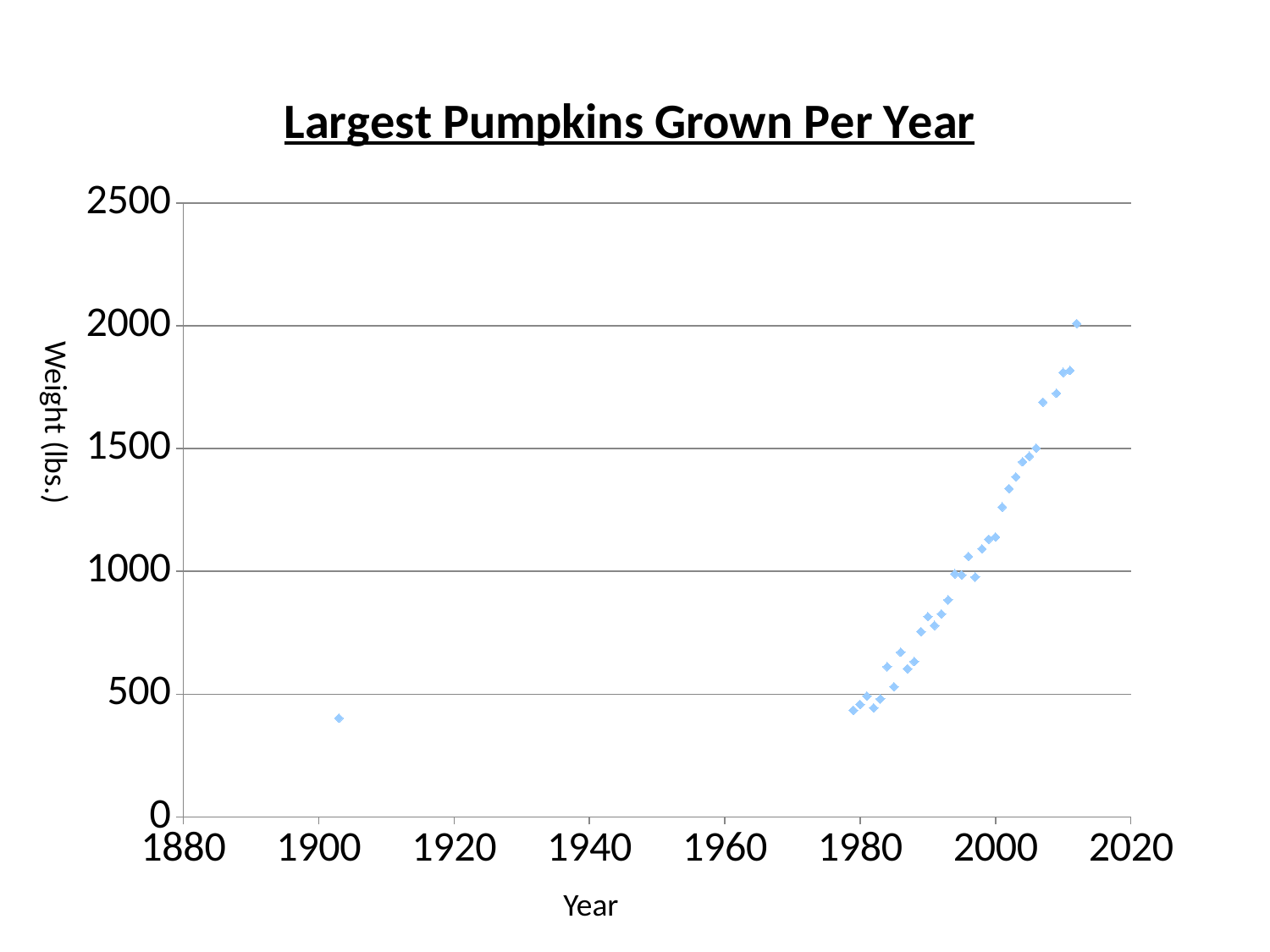
Is the weight for the point plotted near 1990 greater or less than 1000? less Which point shows a heavier pumpkin: the one near 1990 or the one near 2005? 2005 What kind of chart is shown on the slide? scatter chart What is the label of the vertical axis? Weight (lbs.) Is the weight for the point plotted near 1903 greater or less than 500? less Is the weight for the point plotted near 2000 greater or less than 1000? greater Which point shows a heavier pumpkin: the one near 1903 or the one near 2012? 2012 Do the pumpkin weights generally rise or fall as the year increases from 1980 to 2012? rise What is the title of the chart? Largest Pumpkins Grown Per Year